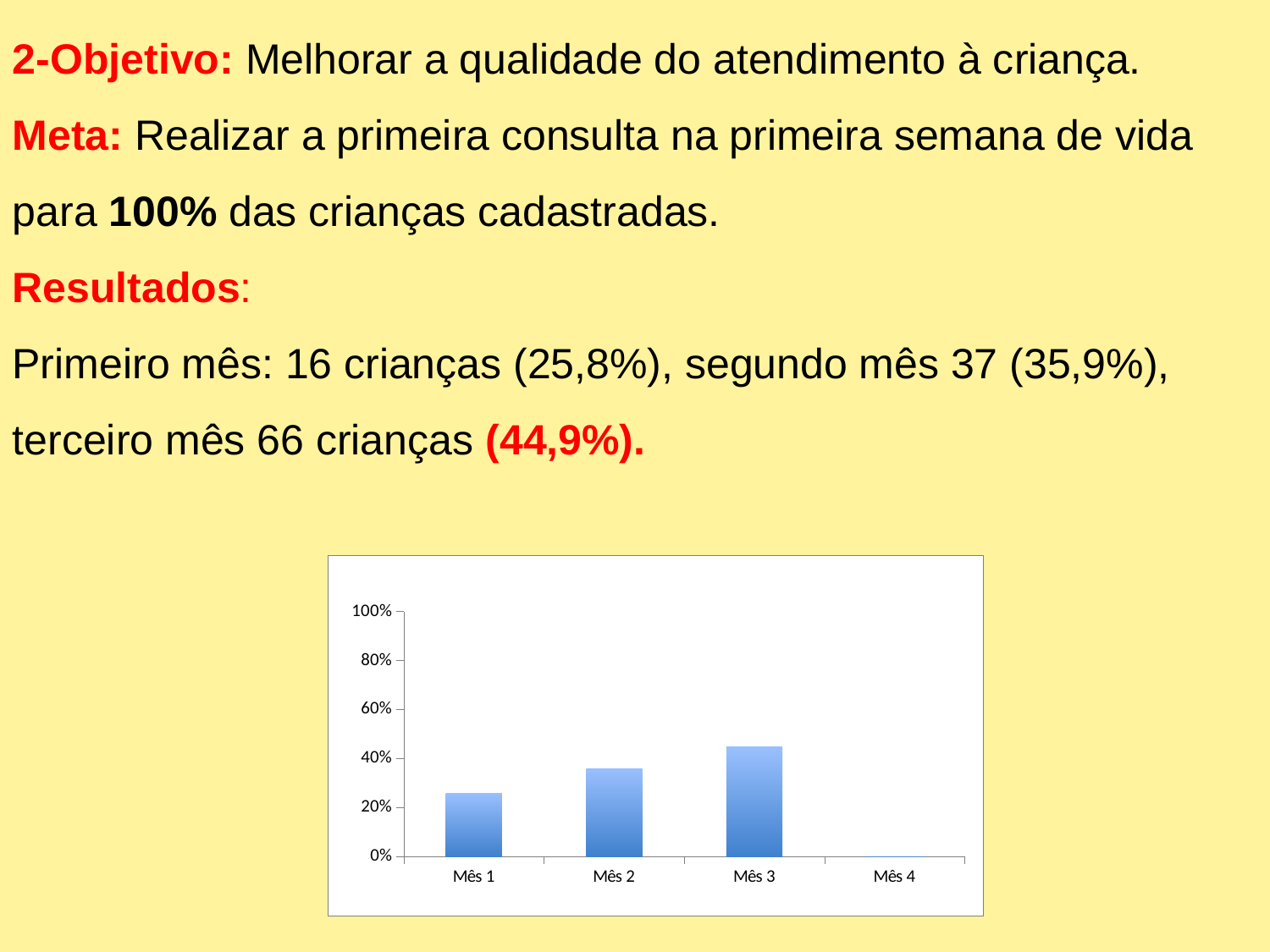
How many categories are shown on the x axis of the chart? 4 Among Mês 1, Mês 2 and Mês 3, which has the lowest bar? Mês 1 Do the bars rise or fall from Mês 1 to Mês 3? rise Is the value for Mês 1 greater or less than 40%? less Is the value for Mês 3 greater or less than 60%? less Is the value for Mês 2 greater or less than 40%? less What is the highest value shown on the chart's vertical axis? 100% Which month has the highest bar in the chart? Mês 3 What kind of chart is shown on the slide? bar chart Which is larger, the bar for Mês 2 or the bar for Mês 3? Mês 3